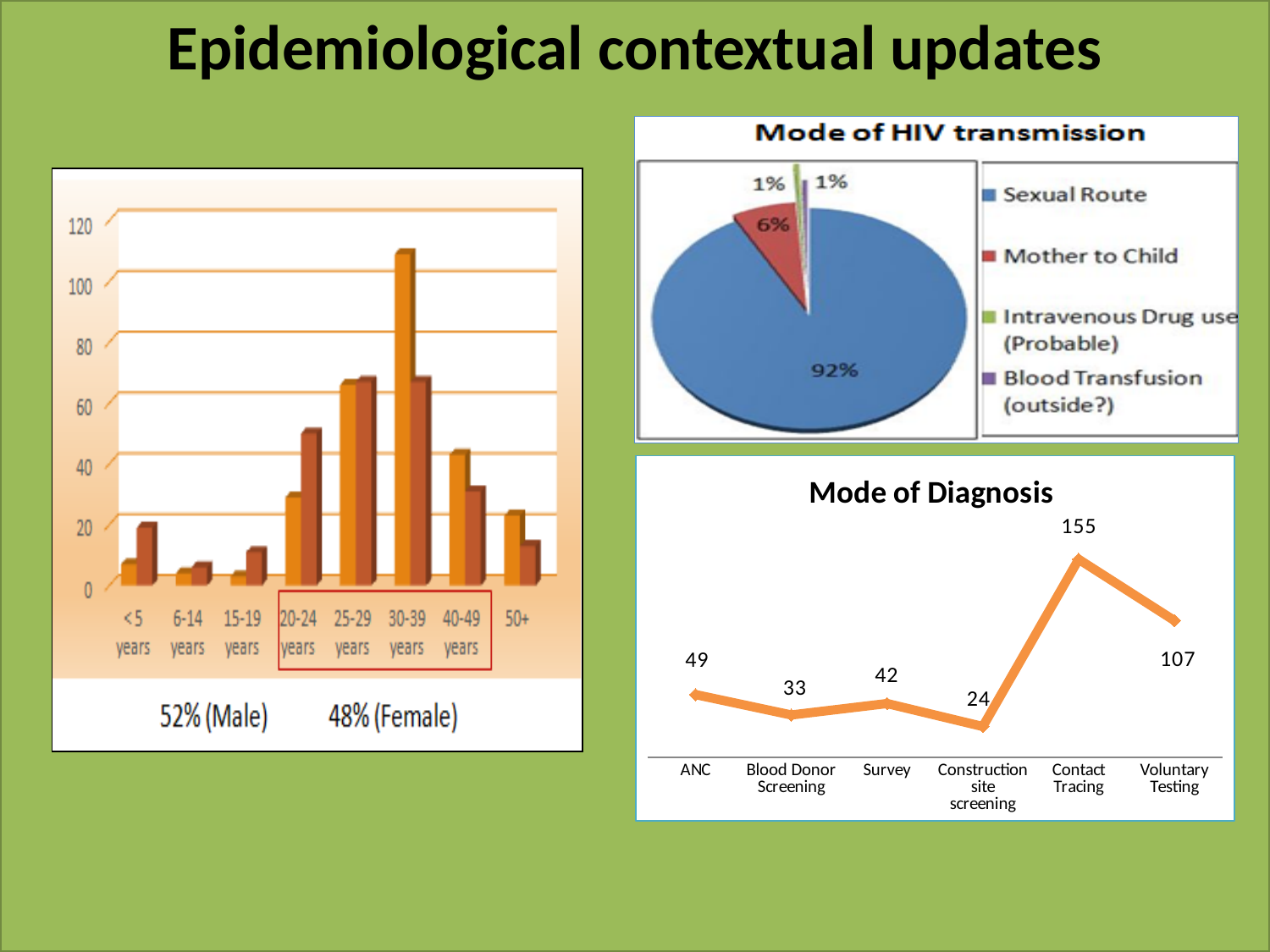
In the Mode of Diagnosis chart, which mode has the highest value? Contact Tracing In the Mode of Diagnosis chart, what is the difference between Contact Tracing and Voluntary Testing? 48 What kind of chart is the Mode of Diagnosis chart? Line chart In the Mode of HIV transmission pie chart, what share is Mother to Child? 6% In the Mode of Diagnosis chart, which mode has the lowest value? Construction site screening In the Mode of Diagnosis chart, what is the value for Construction site screening? 24 In the Mode of Diagnosis chart, which is larger, ANC or Survey? ANC In the bar chart on the left, is the tallest bar for the 30-39 years group greater or less than 100? greater How many categories are shown in the Mode of Diagnosis chart? 6 How many entries does the legend of the Mode of HIV transmission chart list? 4 In the Mode of Diagnosis chart, what is the value for Contact Tracing? 155 In the Mode of HIV transmission pie chart, what share is Sexual Route? 92%